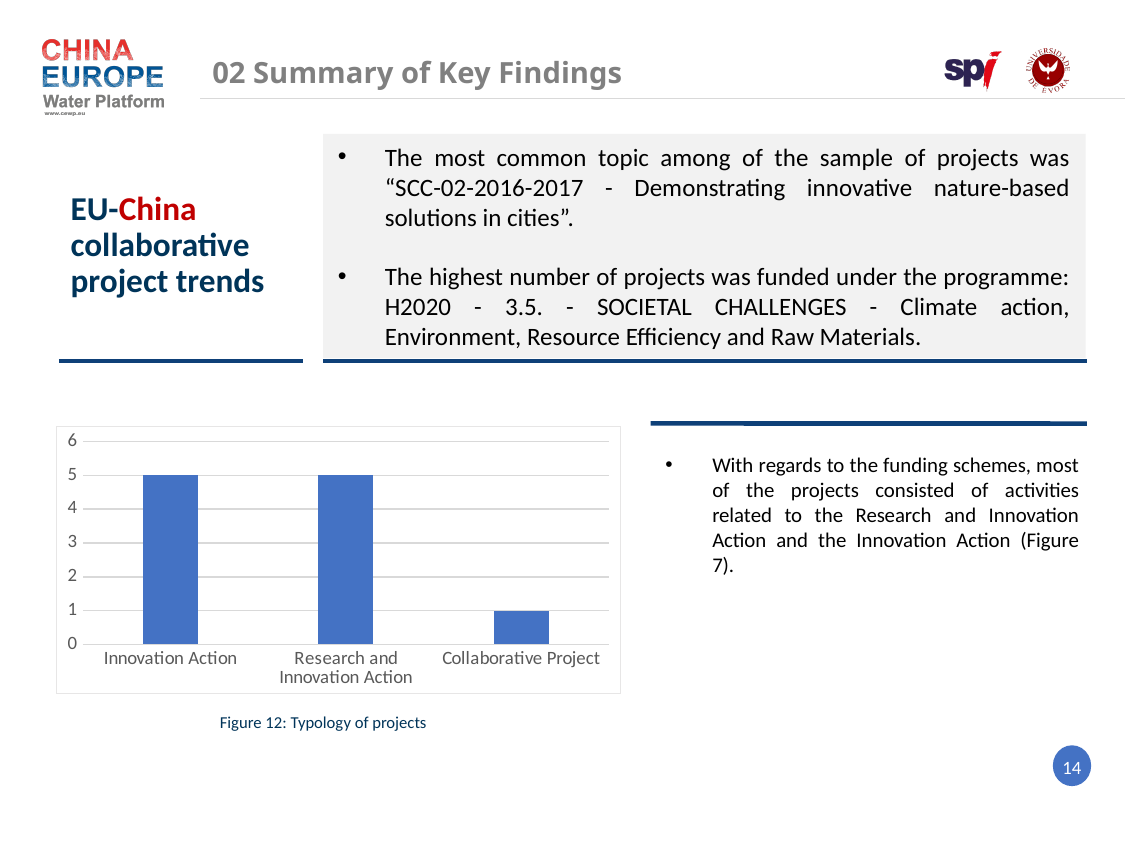
Which category has the lowest value? Collaborative Project Is the value for Collaborative Project greater or less than 2? less What is the value for Research and Innovation Action? 5 What is the highest value shown on the y axis? 6 What kind of chart is shown on the slide? bar chart How many categories are shown on the x axis? 3 Is the value for Innovation Action greater or less than 4? greater What is the value for Innovation Action? 5 What is the difference between the values for Innovation Action and Collaborative Project? 4 Which is larger, the value for Research and Innovation Action or the value for Collaborative Project? Research and Innovation Action What is the figure caption below the chart? Figure 12: Typology of projects What is the value for Collaborative Project? 1